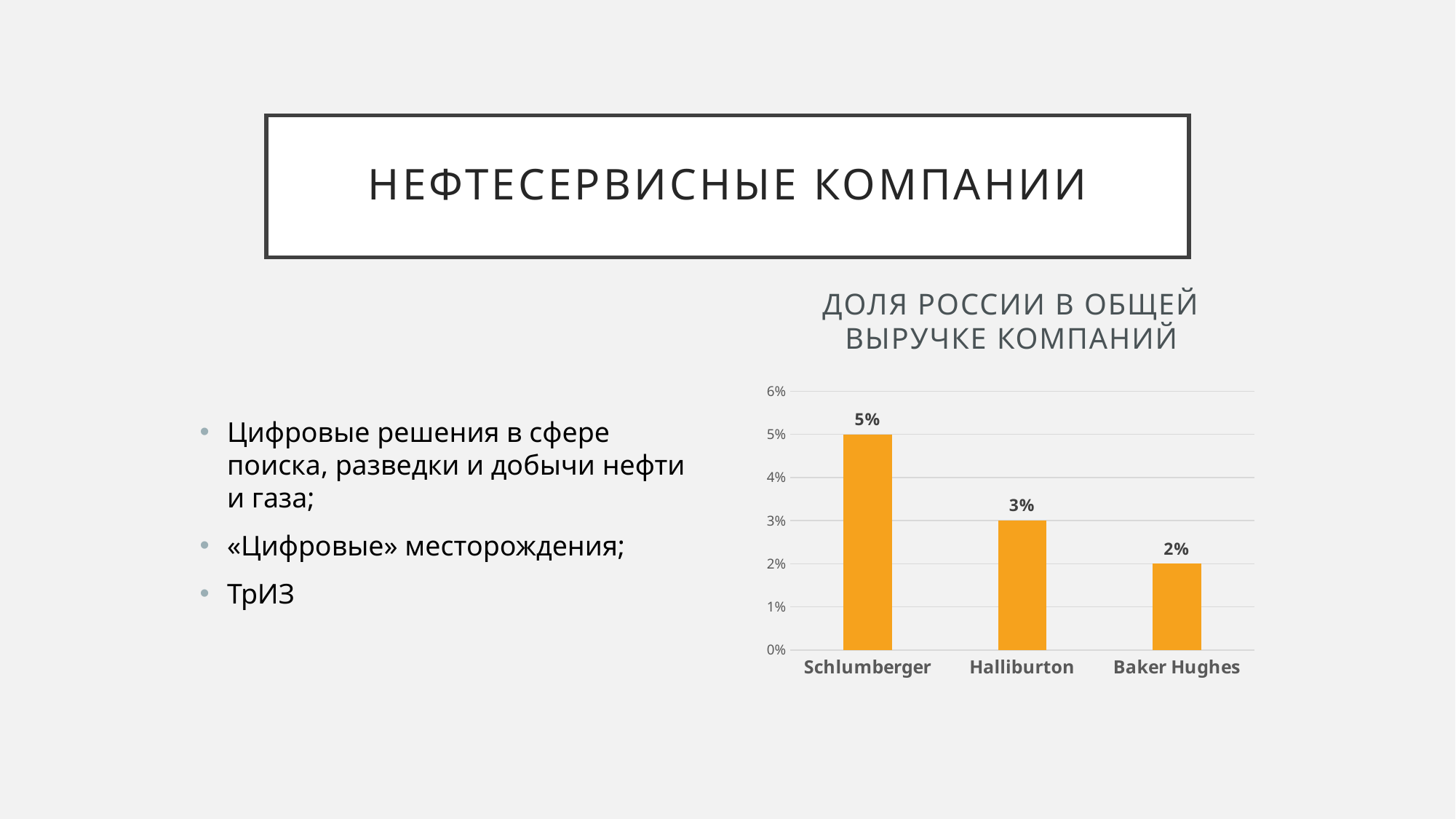
How many companies are shown in the chart? 3 What is the title of the chart? ДОЛЯ РОССИИ В ОБЩЕЙ ВЫРУЧКЕ КОМПАНИЙ What is the value for Schlumberger? 5% Which company has the highest share? Schlumberger What is the difference between the values for Halliburton and Baker Hughes? 1% Is the value for Schlumberger greater or less than 4%? greater Which company has the lowest share? Baker Hughes What is the value for Baker Hughes? 2% What kind of chart is shown on the slide? bar chart What is the difference between the values for Schlumberger and Baker Hughes? 3% What is the value for Halliburton? 3% Which is larger, the value for Halliburton or the value for Baker Hughes? Halliburton